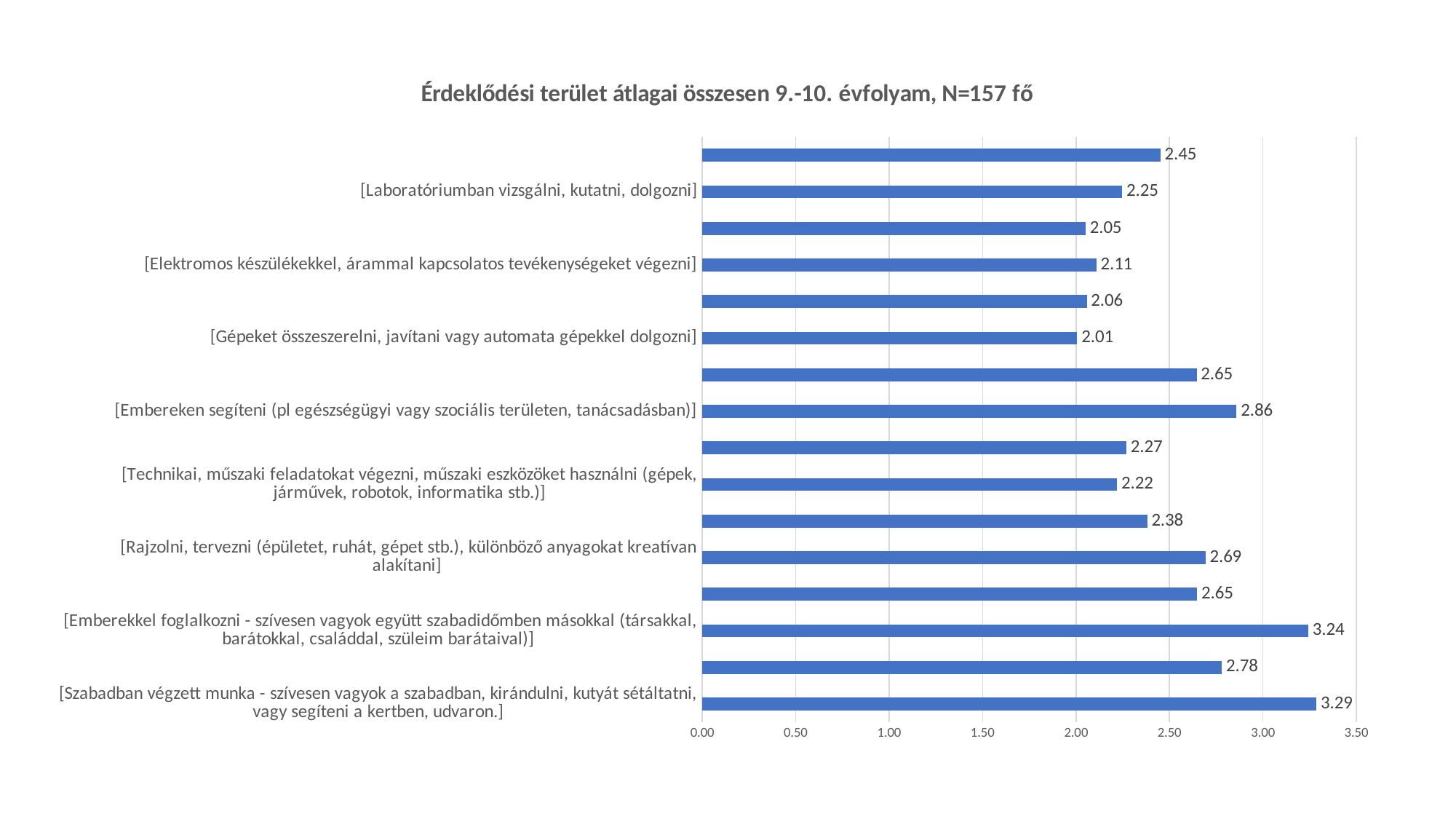
Which labelled category has the highest value? [Szabadban végzett munka - szívesen vagyok a szabadban, kirándulni, kutyát sétáltatni, vagy segíteni a kertben, udvaron.] What is the value for [Emberekkel foglalkozni - szívesen vagyok együtt szabadidőmben másokkal (társakkal, barátokkal, családdal, szüleim barátaival)]? 3.24 Which labelled category has the lowest value? [Gépeket összeszerelni, javítani vagy automata gépekkel dolgozni] How many bars are plotted in the chart? 16 Is the value for [Embereken segíteni (pl egészségügyi vagy szociális területen, tanácsadásban)] greater or less than 2.50? greater What kind of chart is shown on the slide? bar chart What is the value for [Laboratóriumban vizsgálni, kutatni, dolgozni]? 2.25 What is the difference between the value for [Szabadban végzett munka ...] (3.29) and the value for [Gépeket összeszerelni, javítani vagy automata gépekkel dolgozni] (2.01)? 1.28 What is the title of the chart? Érdeklődési terület átlagai összesen 9.-10. évfolyam, N=157 fő Which is larger: the value for [Rajzolni, tervezni (épületet, ruhát, gépet stb.), különböző anyagokat kreatívan alakítani] or the value for [Technikai, műszaki feladatokat végezni, műszaki eszközöket használni (gépek, járművek, robotok, informatika stb.)]? [Rajzolni, tervezni (épületet, ruhát, gépet stb.), különböző anyagokat kreatívan alakítani] What is the value for [Embereken segíteni (pl egészségügyi vagy szociális területen, tanácsadásban)]? 2.86 What is the value for [Elektromos készülékekkel, árammal kapcsolatos tevékenységeket végezni]? 2.11